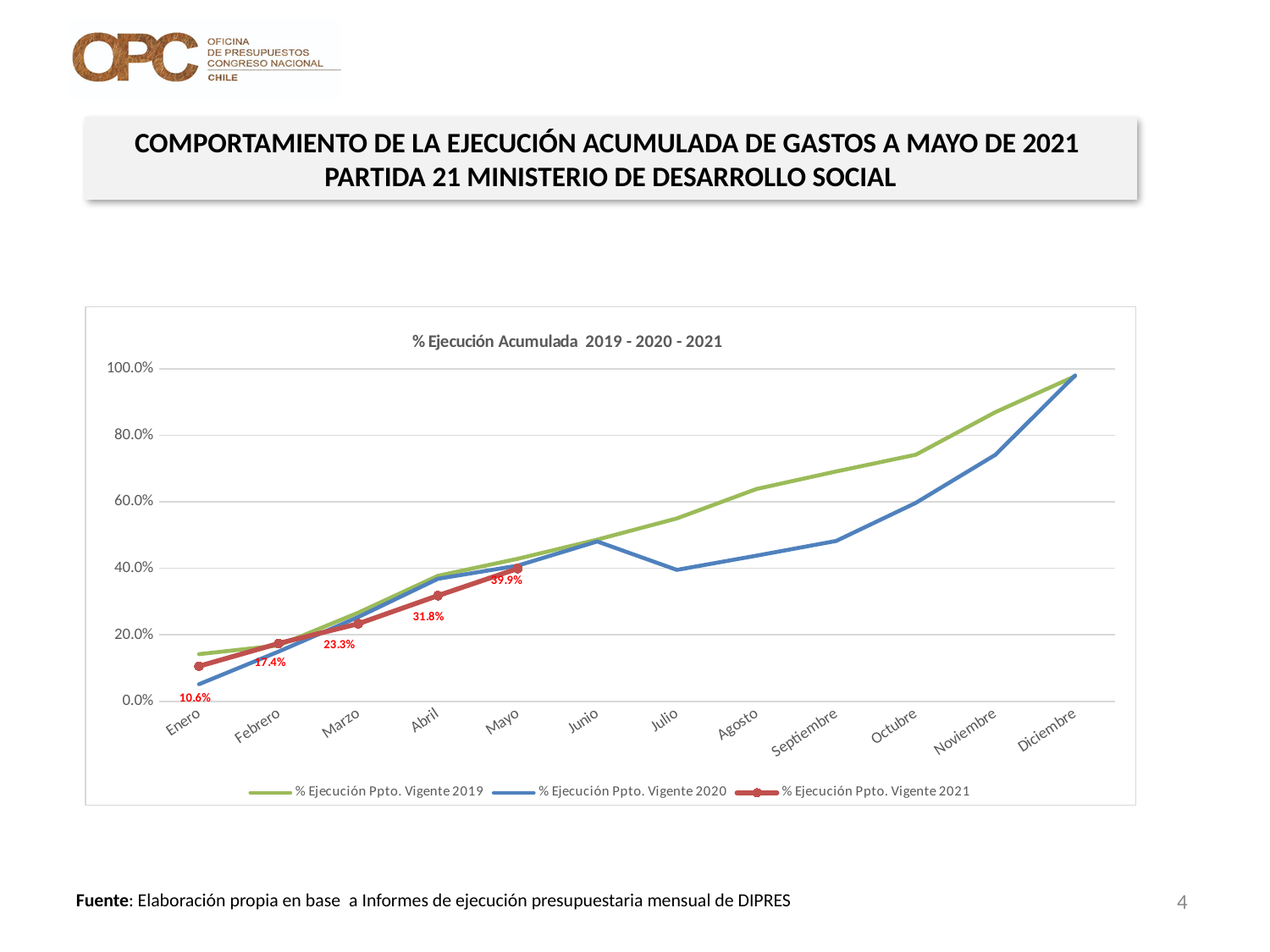
What is the value of the % Ejecución Ppto. Vigente 2021 series for Marzo? 23.3% What is the difference between the 2021 values for Abril and Marzo? 8.5 percentage points Which series has the higher value in Septiembre, 2019 or 2020? % Ejecución Ppto. Vigente 2019 Which month has the highest value in the % Ejecución Ppto. Vigente 2021 series? Mayo How many series does the legend list? 3 What is the value of the % Ejecución Ppto. Vigente 2021 series for Mayo? 39.9% How many months are shown on the x axis? 12 What is the difference between the 2021 values for Mayo and Enero? 29.3 percentage points What is the value of the % Ejecución Ppto. Vigente 2021 series for Enero? 10.6% Does the % Ejecución Ppto. Vigente 2021 series rise or fall from Enero to Mayo? Rise What kind of chart is shown on the slide? Line chart Is the value of the % Ejecución Ppto. Vigente 2020 series for Septiembre greater or less than 60%? less